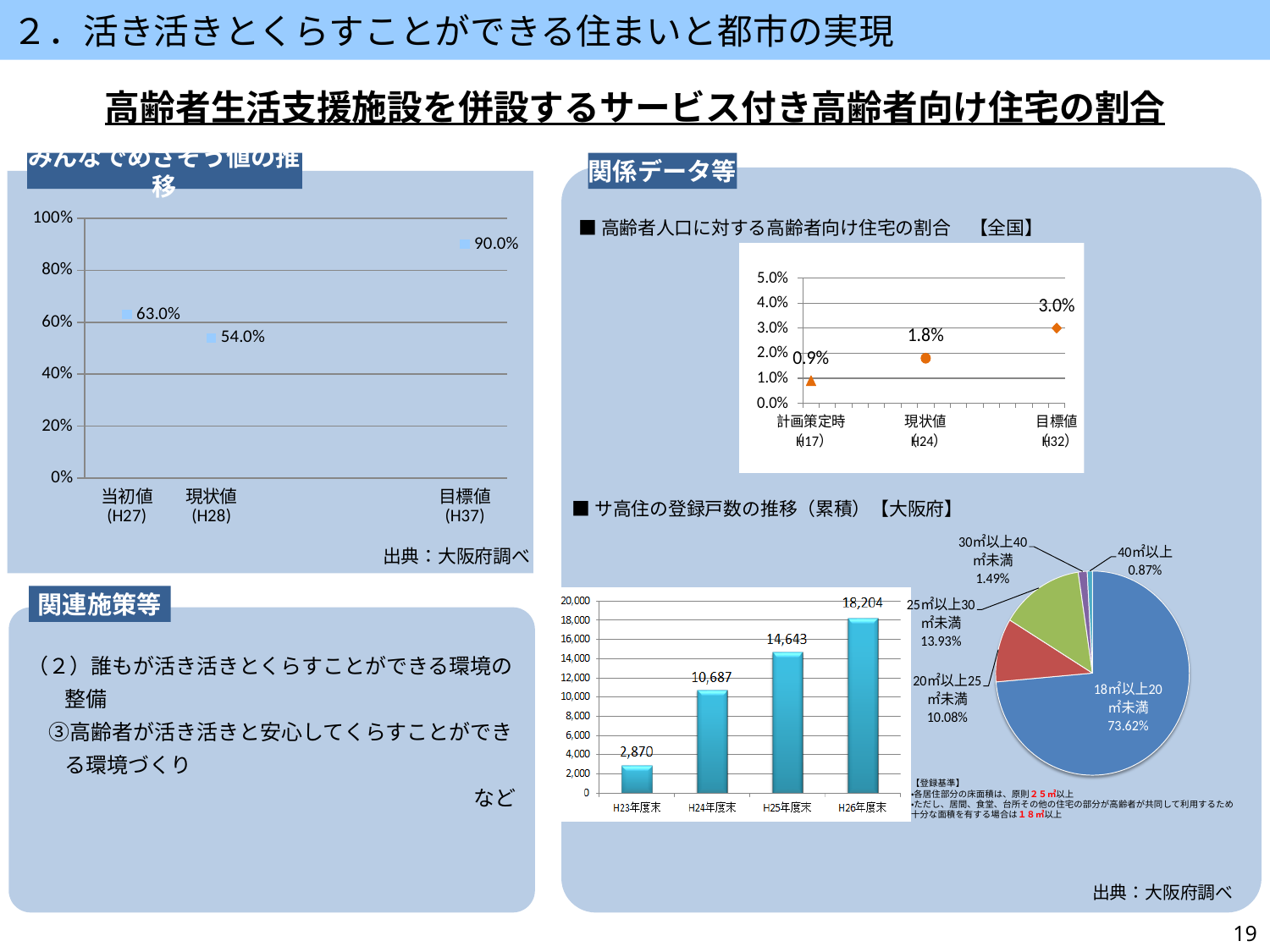
In the chart titled みんなでめざそう値の推移 on the left, what is the value for 現状値 (H28)? 54.0% In the bar chart titled サ高住の登録戸数の推移（累積）【大阪府】, what is the difference between the H26年度末 value and the H23年度末 value? 15,334 In the bar chart titled サ高住の登録戸数の推移（累積）【大阪府】, what is the value for H25年度末? 14,643 In the chart titled 高齢者人口に対する高齢者向け住宅の割合【全国】, what is the value for 現状値 (H24)? 1.8% In the chart titled みんなでめざそう値の推移 on the left, what is the value for 目標値 (H37)? 90.0% In the chart titled 高齢者人口に対する高齢者向け住宅の割合【全国】, which category has the lowest value? 計画策定時 (H17) In the bar chart titled サ高住の登録戸数の推移（累積）【大阪府】, how many bars are plotted? 4 In the pie chart at the bottom right, what share does the 18㎡以上20㎡未満 slice have? 73.62% In the chart titled 高齢者人口に対する高齢者向け住宅の割合【全国】, do the values rise or fall from left to right? rise In the chart titled みんなでめざそう値の推移 on the left, what is the difference between the 当初値 (H27) value and the 現状値 (H28) value? 9.0% In the pie chart at the bottom right, which is larger: the 25㎡以上30㎡未満 slice or the 20㎡以上25㎡未満 slice? 25㎡以上30㎡未満 What kind of chart is the chart titled サ高住の登録戸数の推移（累積）【大阪府】? bar chart